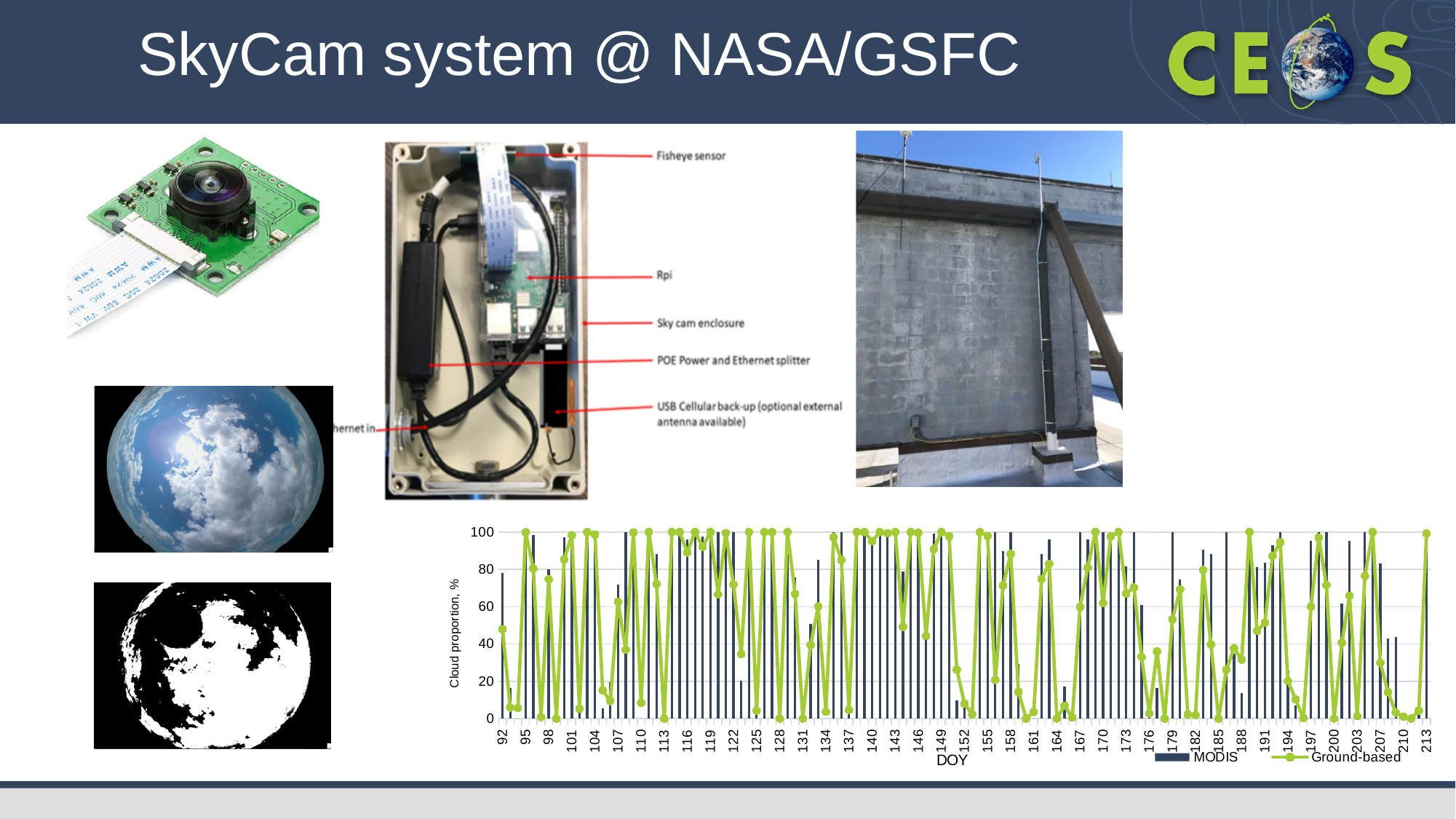
Which series in the cloud proportion chart is drawn as a green line with markers? Ground-based What is the first DOY value shown on the x axis of the chart? 92 Is the Ground-based cloud proportion at DOY 161 greater or less than 20? less Is the Ground-based cloud proportion at DOY 213 greater or less than 80? greater What is the last DOY value shown on the x axis of the chart? 213 What are the two series named in the legend of the cloud proportion chart? MODIS and Ground-based What kind of chart is shown at the bottom of the slide? A combined bar and line chart What is the label of the y axis of the chart? Cloud proportion, % Is the Ground-based cloud proportion at DOY 95 greater or less than 80? greater What is the maximum value shown on the y axis of the chart? 100 How many series does the legend of the cloud proportion chart list? 2 What is the label of the x axis of the chart? DOY